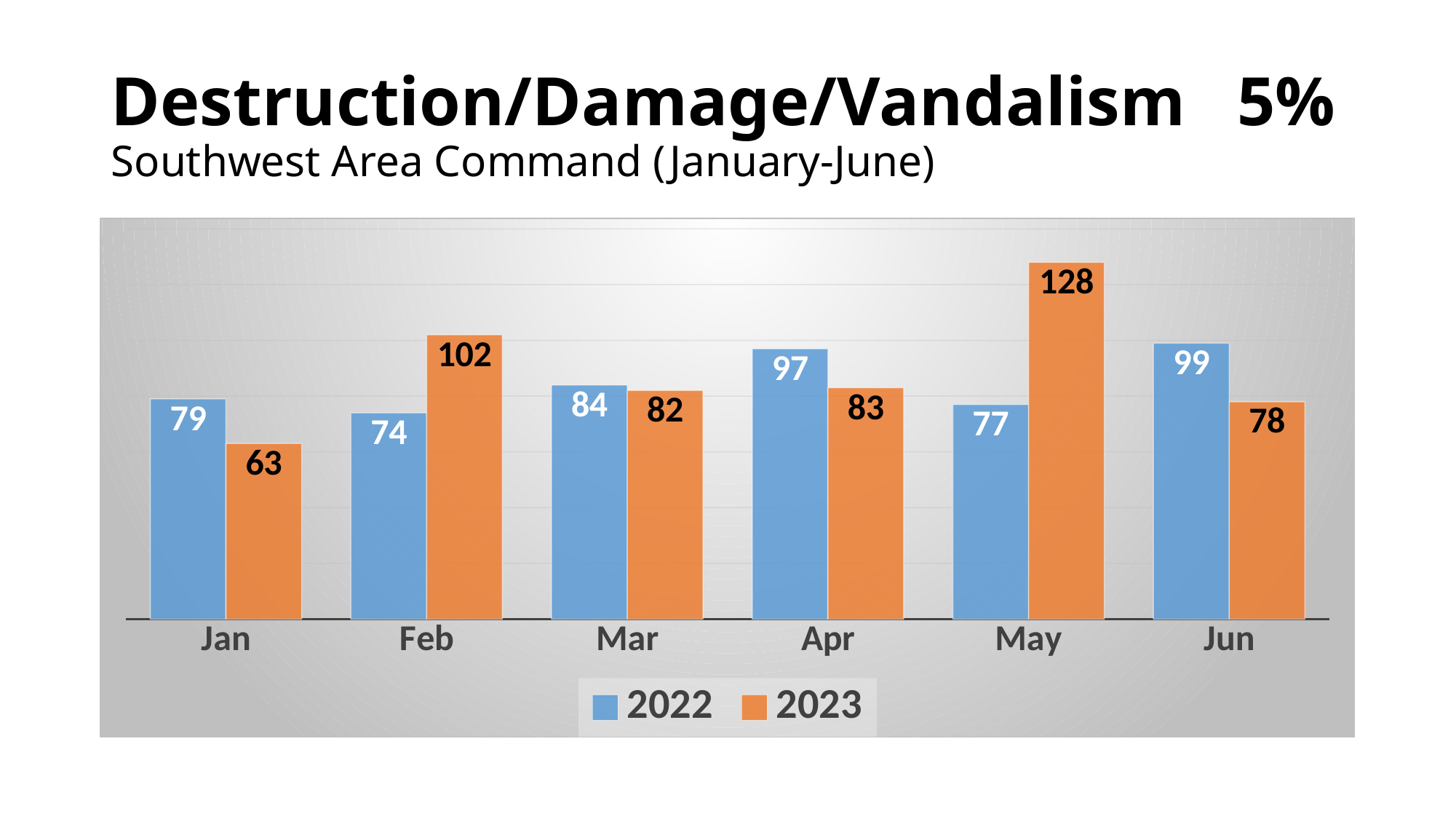
Which month has the highest value for 2023? May How many months are shown on the x axis? 6 Which month has the lowest value for 2023? Jan What is the difference between the 2023 and 2022 values in May? 51 What is the difference between the 2022 and 2023 values in Jun? 21 What is the value for 2023 in Jan? 63 What kind of chart is shown on the slide? Bar chart Which is larger in Feb, the 2022 value or the 2023 value? 2023 Which month has the lowest value for 2022? Feb What is the value for 2023 in May? 128 What is the value for 2022 in Feb? 74 How many series does the legend list? 2